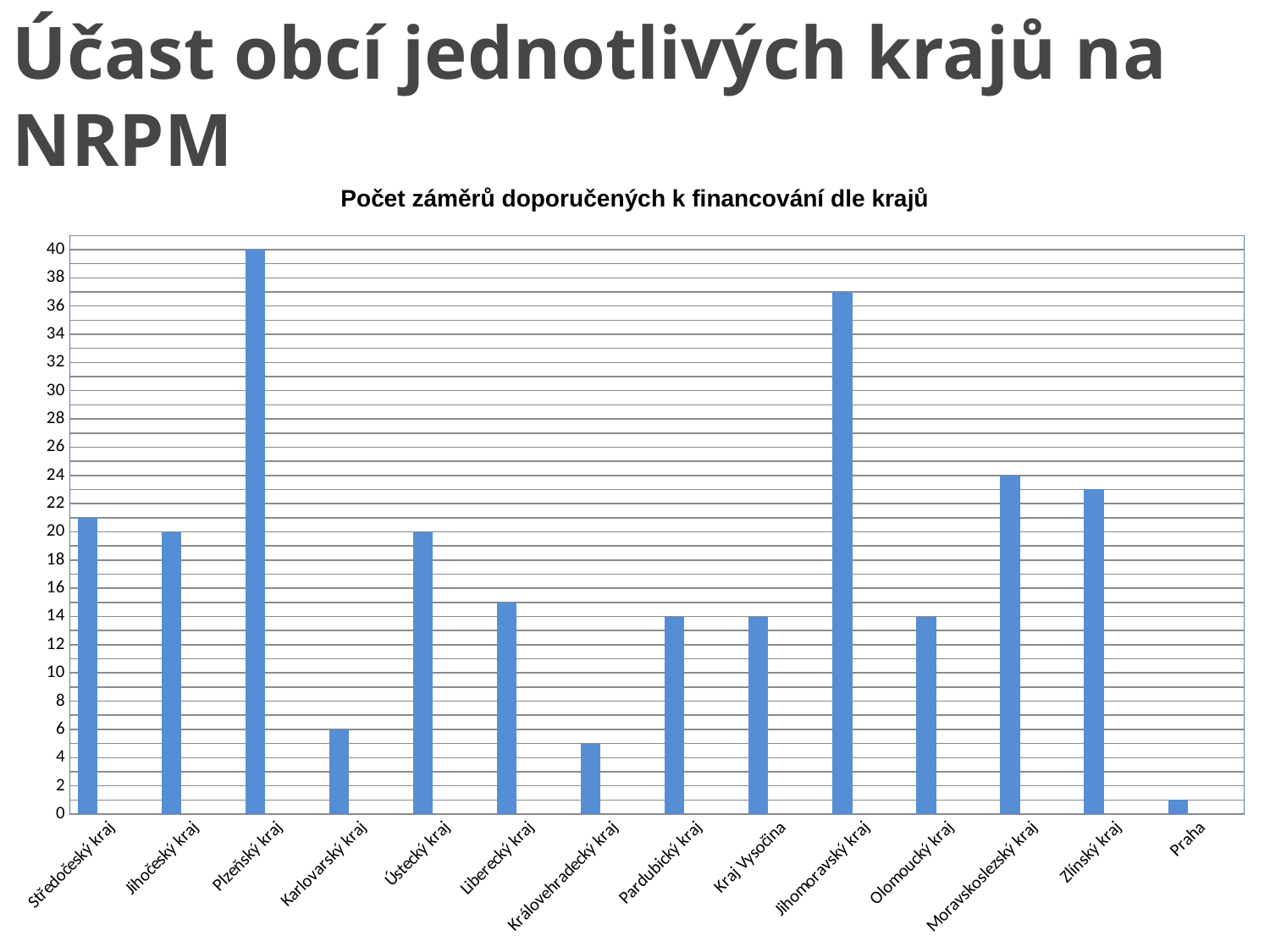
How many regions (categories) are shown on the x axis? 14 What is the value for Moravskoslezský kraj? 24 Which region has the highest value? Plzeňský kraj What is the difference between the values for Plzeňský kraj and Moravskoslezský kraj? 16 What kind of chart is shown on the slide? bar chart What is the title of the chart? Počet záměrů doporučených k financování dle krajů Is the value for Jihomoravský kraj greater or less than 30? greater What is the value for Karlovarský kraj? 6 What is the value for Pardubický kraj? 14 Which region has the lowest value? Praha What is the value for Plzeňský kraj? 40 Which is larger, the value for Jihomoravský kraj or the value for Zlínský kraj? Jihomoravský kraj